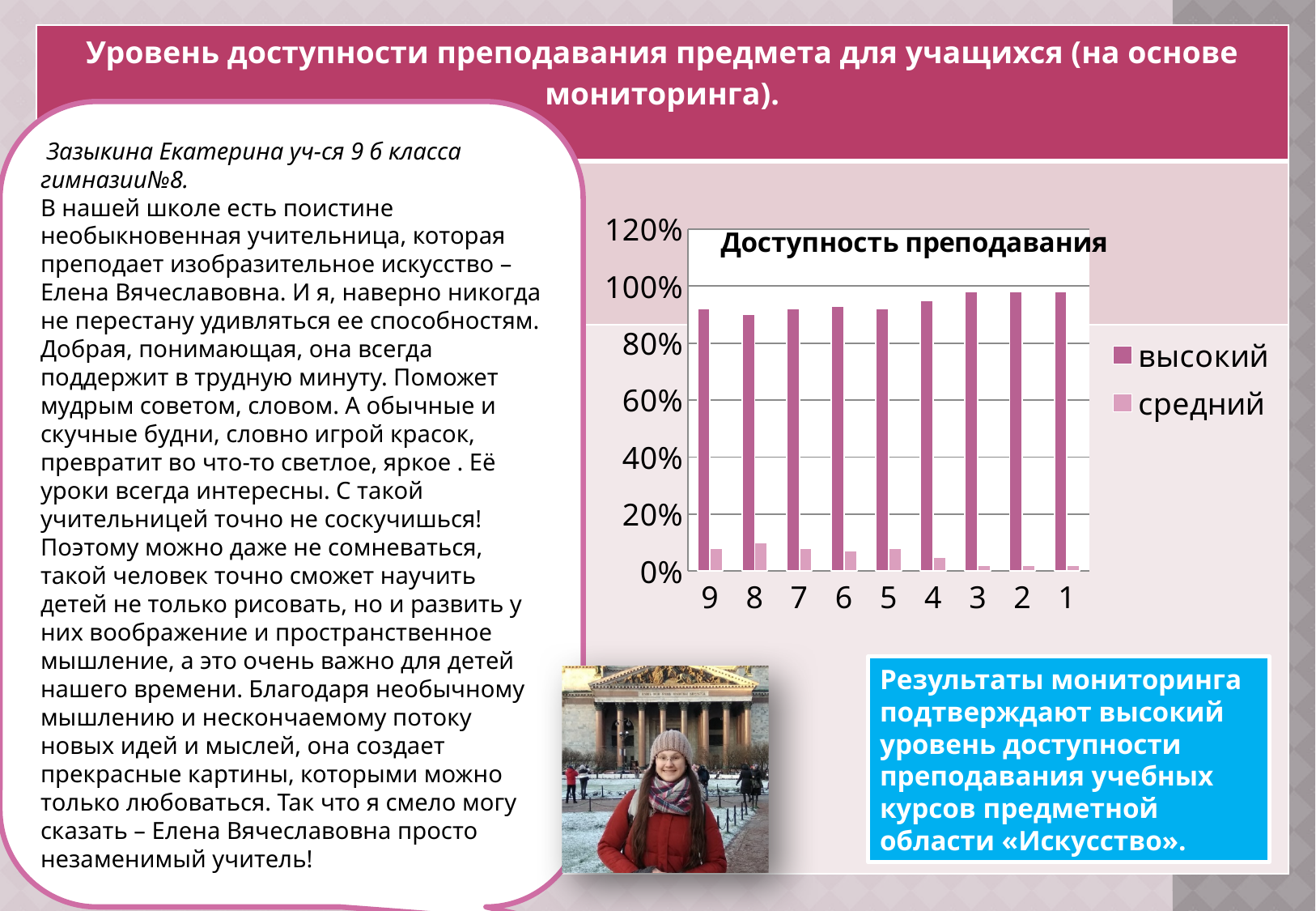
Is the value of the высокий series for category 9 greater or less than 80%? greater What kind of chart is shown on the slide? bar chart For category 5, which series has the larger value, высокий or средний? высокий How many categories are shown along the x axis of the chart? 9 Is the value of the высокий series for category 4 greater or less than 60%? greater Do the values of the средний series generally rise or fall moving from category 9 to category 1 along the x axis? fall Is the value of the средний series for category 8 greater or less than 20%? less How many series does the chart legend list? 2 What is the title of the chart? Доступность преподавания Which series is drawn in the darker pink colour? высокий